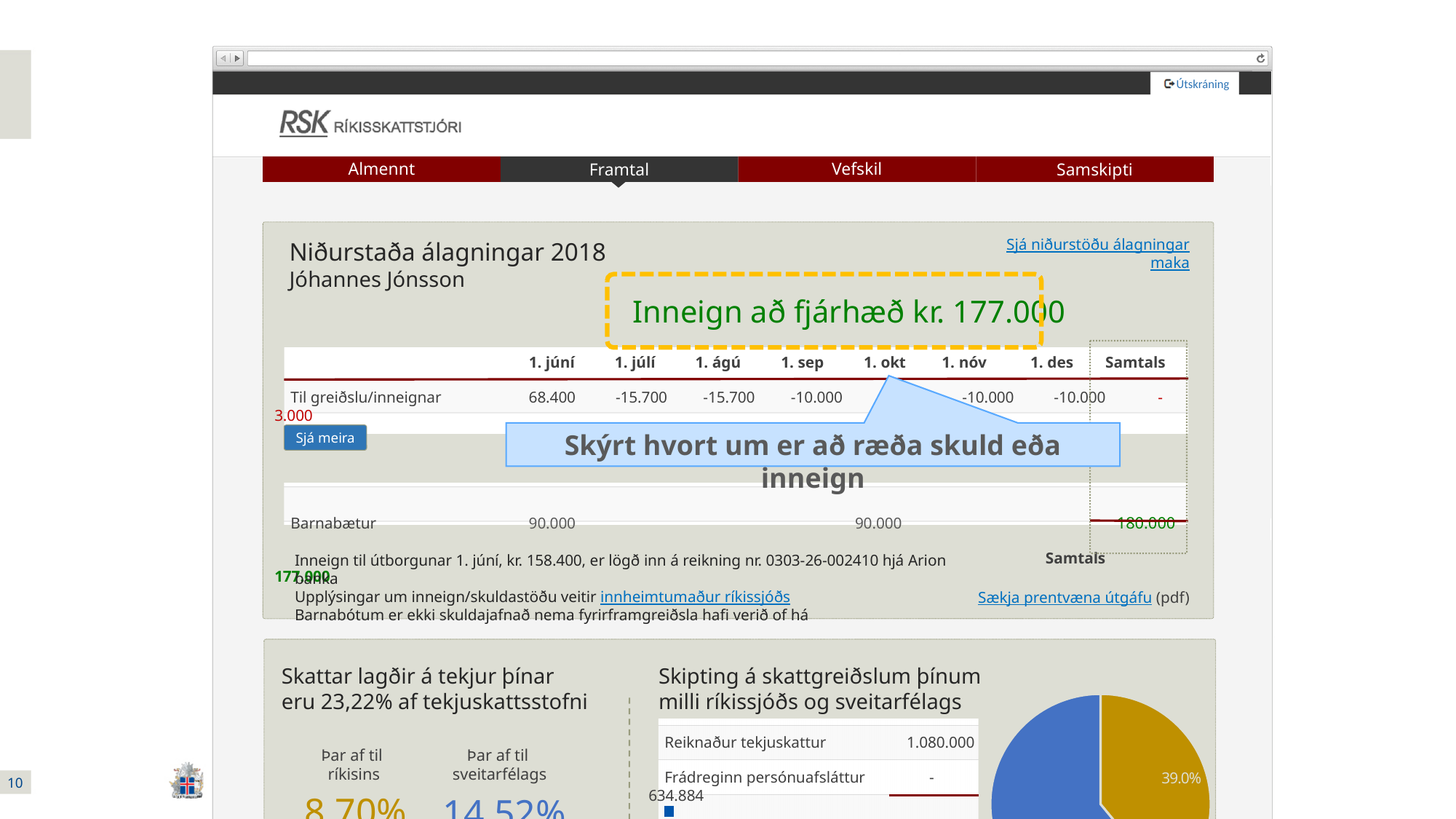
What kind of chart is shown at the bottom right of the slide? Pie chart In the pie chart at the bottom right, what share of the pie does the gold slice represent? 39.0% In the pie chart at the bottom right, what percentage is printed on the gold slice? 39.0% In the pie chart at the bottom right, what colour is the slice labelled 39.0%? Gold In the pie chart at the bottom right, which slice is larger, the blue one or the gold one? Blue What is the title above the pie chart at the bottom right of the slide? Skipting á skattgreiðslum þínum milli ríkissjóðs og sveitarfélags